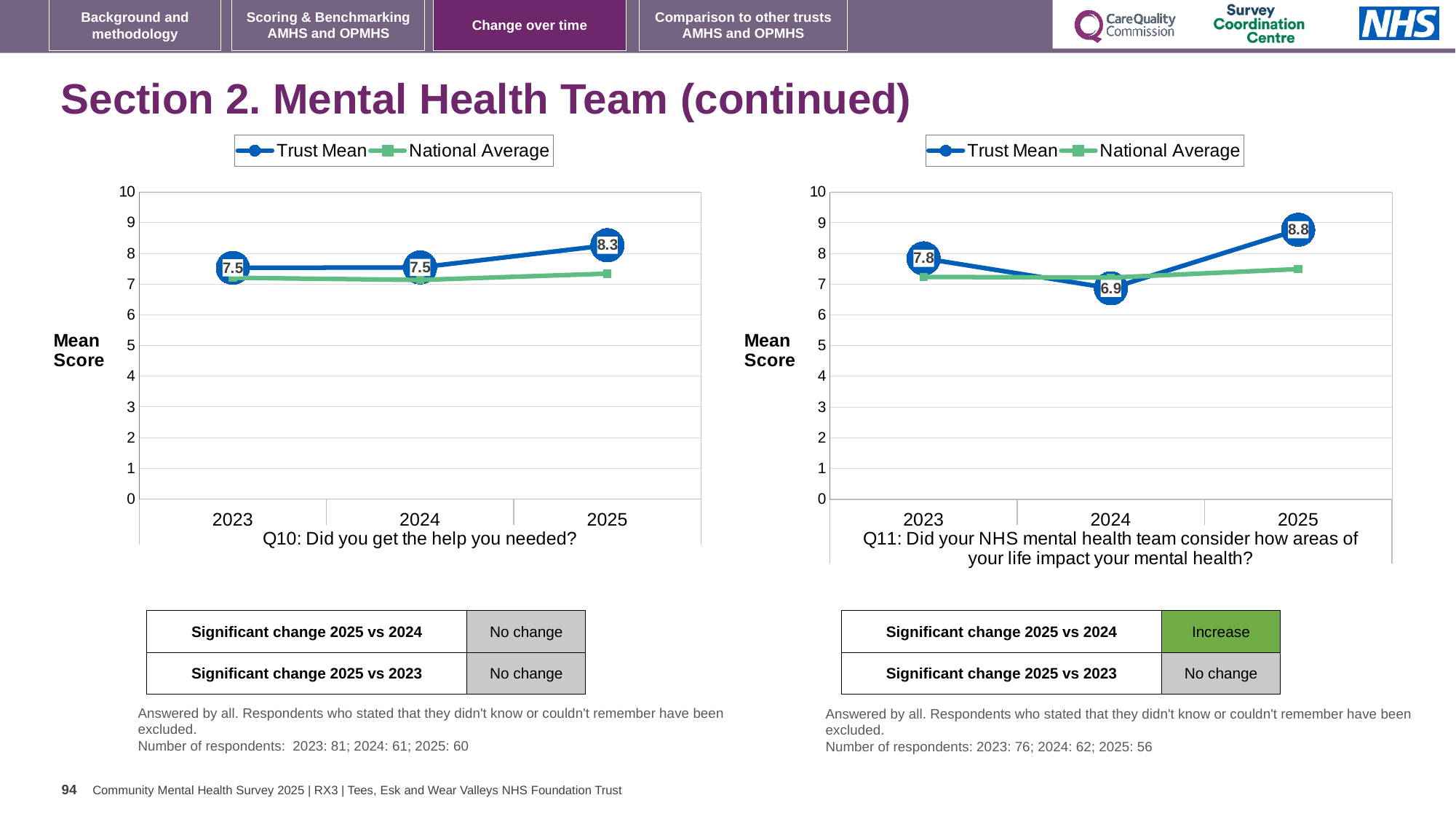
In the Q11 chart (right), which year has the highest Trust Mean score? 2025 How many series does the legend of the Q11 chart (right) list? 2 In the Q11 chart (right), what is the Trust Mean score for 2023? 7.8 What type of chart is used for Q10 (left)? Line chart In the Q11 chart (right), which year has the lowest Trust Mean score? 2024 In the Q10 chart (left), what is the Trust Mean score for 2025? 8.3 In the Q11 chart (right), what is the Trust Mean score for 2024? 6.9 In the Q10 chart (left), what is the difference between the Trust Mean scores for 2025 and 2024? 0.8 In the Q11 chart (right), is the Trust Mean for 2023 or 2025 higher? 2025 How many years are shown on the x axis of the Q10 chart (left)? 3 In the Q11 chart (right), what is the difference between the Trust Mean scores for 2025 and 2024? 1.9 In the Q10 chart (left), is the National Average value for 2025 greater or less than 8? less